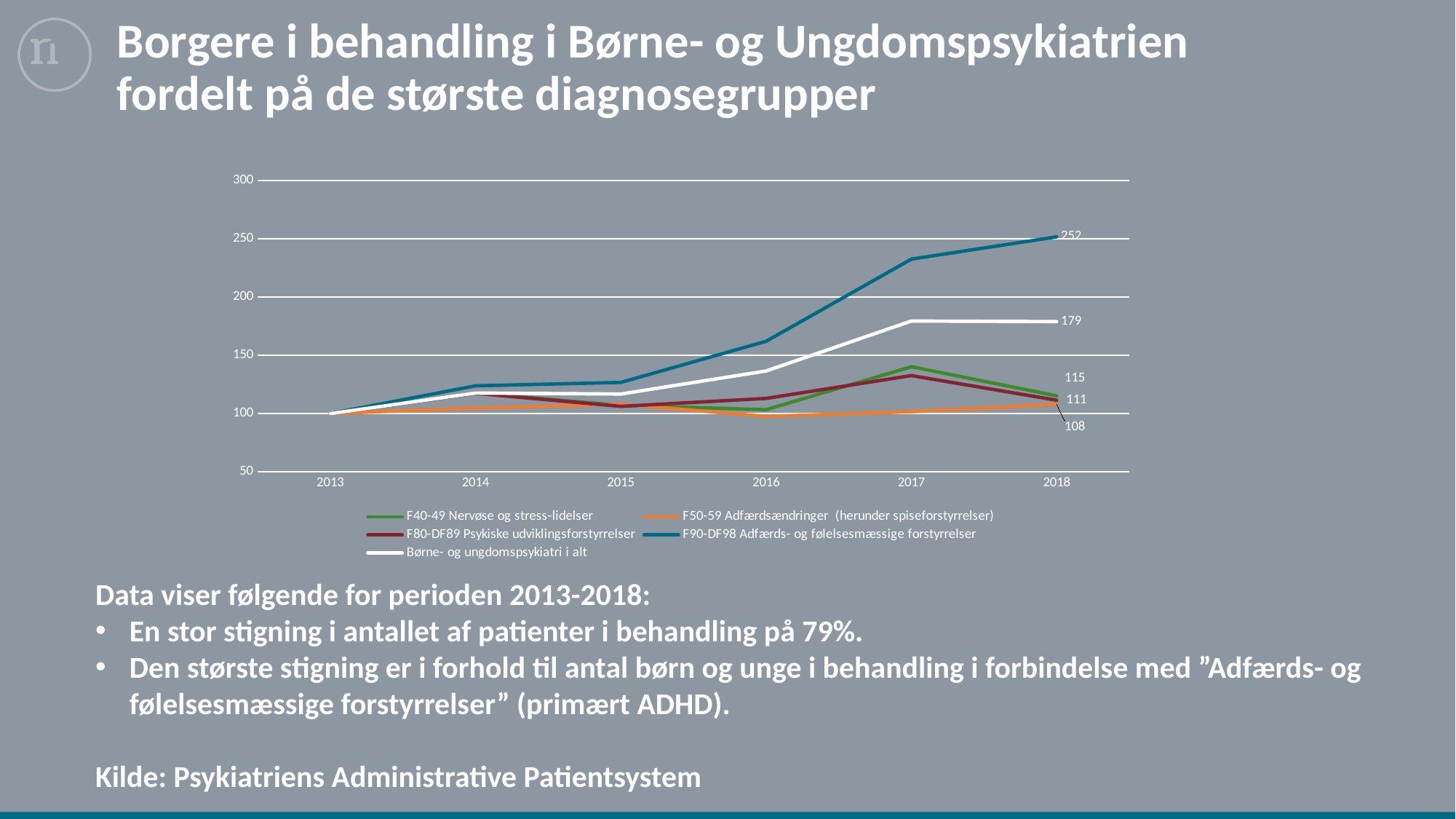
What type of chart is shown on the slide? line chart What is the value for F90-DF98 Adfærds- og følelsesmæssige forstyrrelser in 2018? 252 In 2018, which is larger: the value for F90-DF98 Adfærds- og følelsesmæssige forstyrrelser or the value for F40-49 Nervøse og stress-lidelser? F90-DF98 Adfærds- og følelsesmæssige forstyrrelser What is the difference between the 2018 values for F90-DF98 Adfærds- og følelsesmæssige forstyrrelser and Børne- og ungdomspsykiatri i alt? 73 What colour is the line for Børne- og ungdomspsykiatri i alt? white Does the F90-DF98 Adfærds- og følelsesmæssige forstyrrelser series rise or fall from 2013 to 2018? rise Is the value for Børne- og ungdomspsykiatri i alt in 2016 greater or less than 150? less How many series does the legend list? 5 Which series has the highest value in 2018? F90-DF98 Adfærds- og følelsesmæssige forstyrrelser Is the value for F90-DF98 Adfærds- og følelsesmæssige forstyrrelser in 2017 greater or less than 200? greater What is the value for Børne- og ungdomspsykiatri i alt in 2018? 179 How many years are shown on the x axis? 6